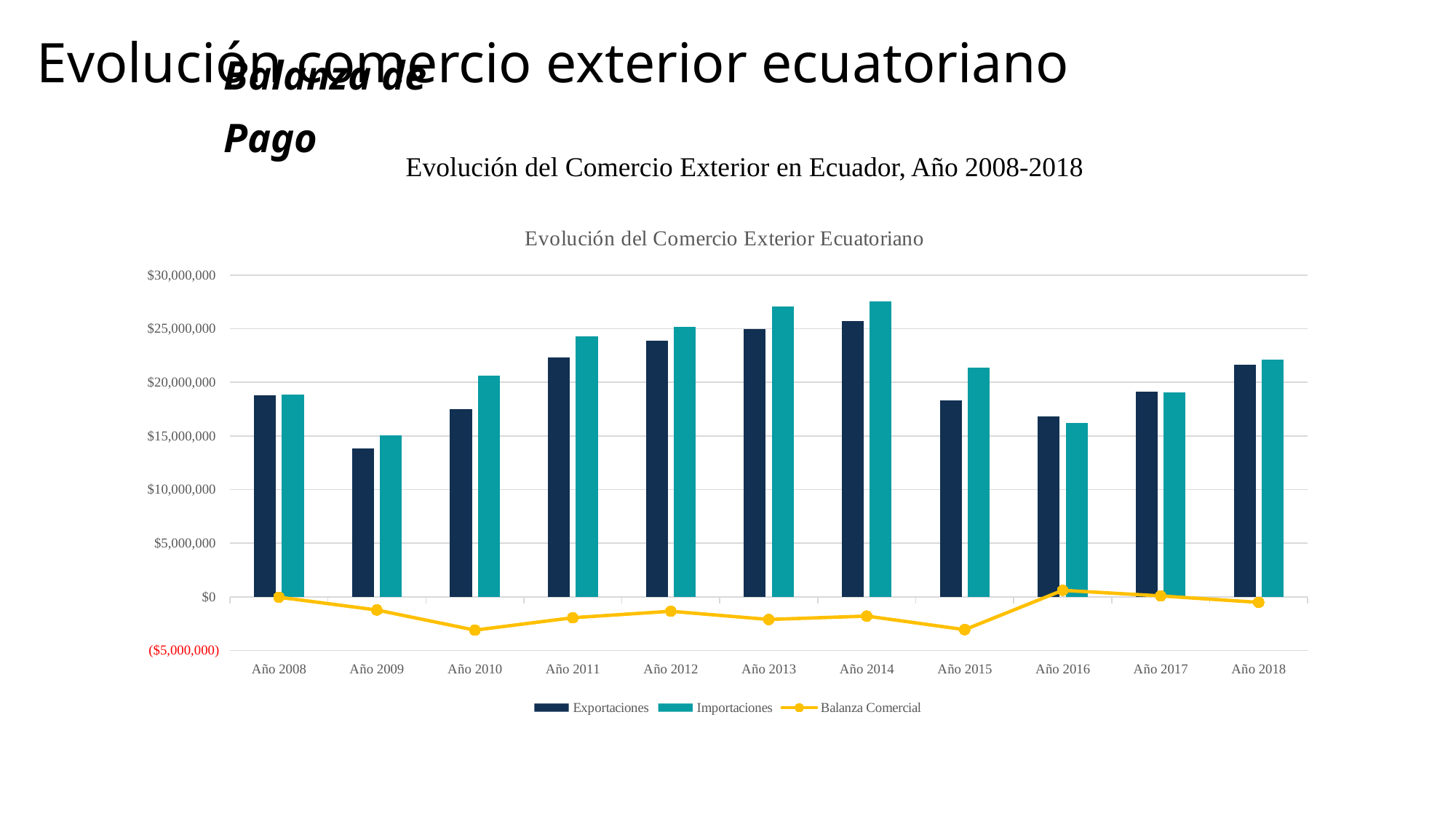
Is the value of Exportaciones in Año 2009 greater or less than $15,000,000? less In which year are Exportaciones highest? Año 2014 How many years are shown on the x axis of the chart? 11 In which year are Importaciones highest? Año 2014 What kind of chart is used for the Exportaciones and Importaciones series? Bar chart In Año 2010, which is larger, Exportaciones or Importaciones? Importaciones How many series does the chart legend list? 3 What is the title of the chart? Evolución del Comercio Exterior Ecuatoriano In which year are Exportaciones lowest? Año 2009 In which year are Importaciones lowest? Año 2009 Is the value of Importaciones in Año 2013 greater or less than $25,000,000? greater Do Exportaciones rise or fall from Año 2009 to Año 2014? Rise